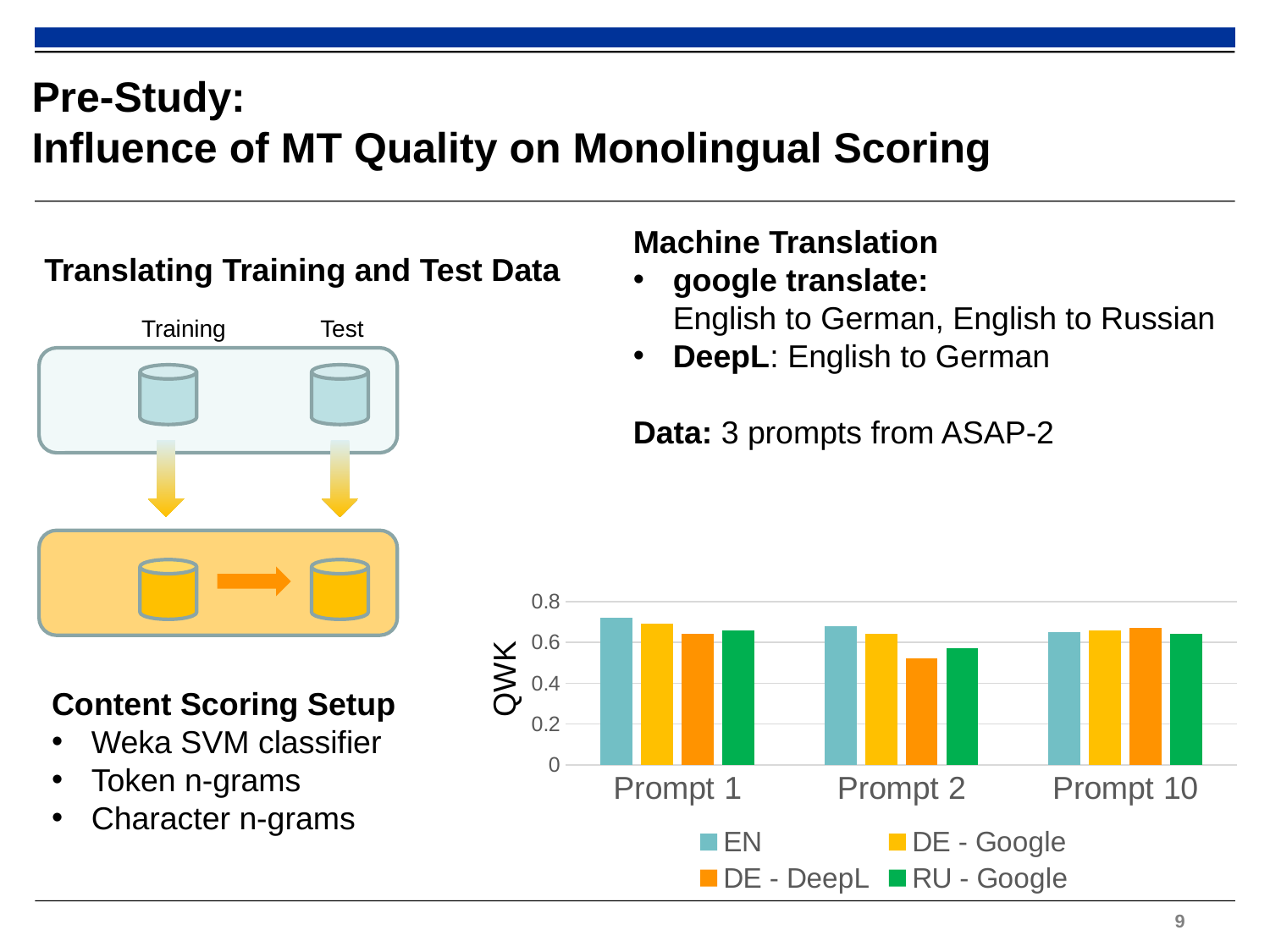
Which series in the chart is shown in green? RU - Google Which series has the lowest value for Prompt 2? DE - DeepL How many series does the chart legend list? 4 Is the value for DE - DeepL on Prompt 2 greater or less than 0.6? less Which bar in the whole chart is the lowest? DE - DeepL on Prompt 2 Which series has the highest value for Prompt 1? EN Is the value for EN on Prompt 1 greater or less than 0.6? greater For Prompt 2, which is larger: the EN value or the DE - DeepL value? EN How many prompts (categories) are shown on the x axis of the chart? 3 Is the value for EN on Prompt 1 greater or less than 0.8? less What kind of chart is shown on the slide? bar chart What is the label of the vertical axis of the chart? QWK